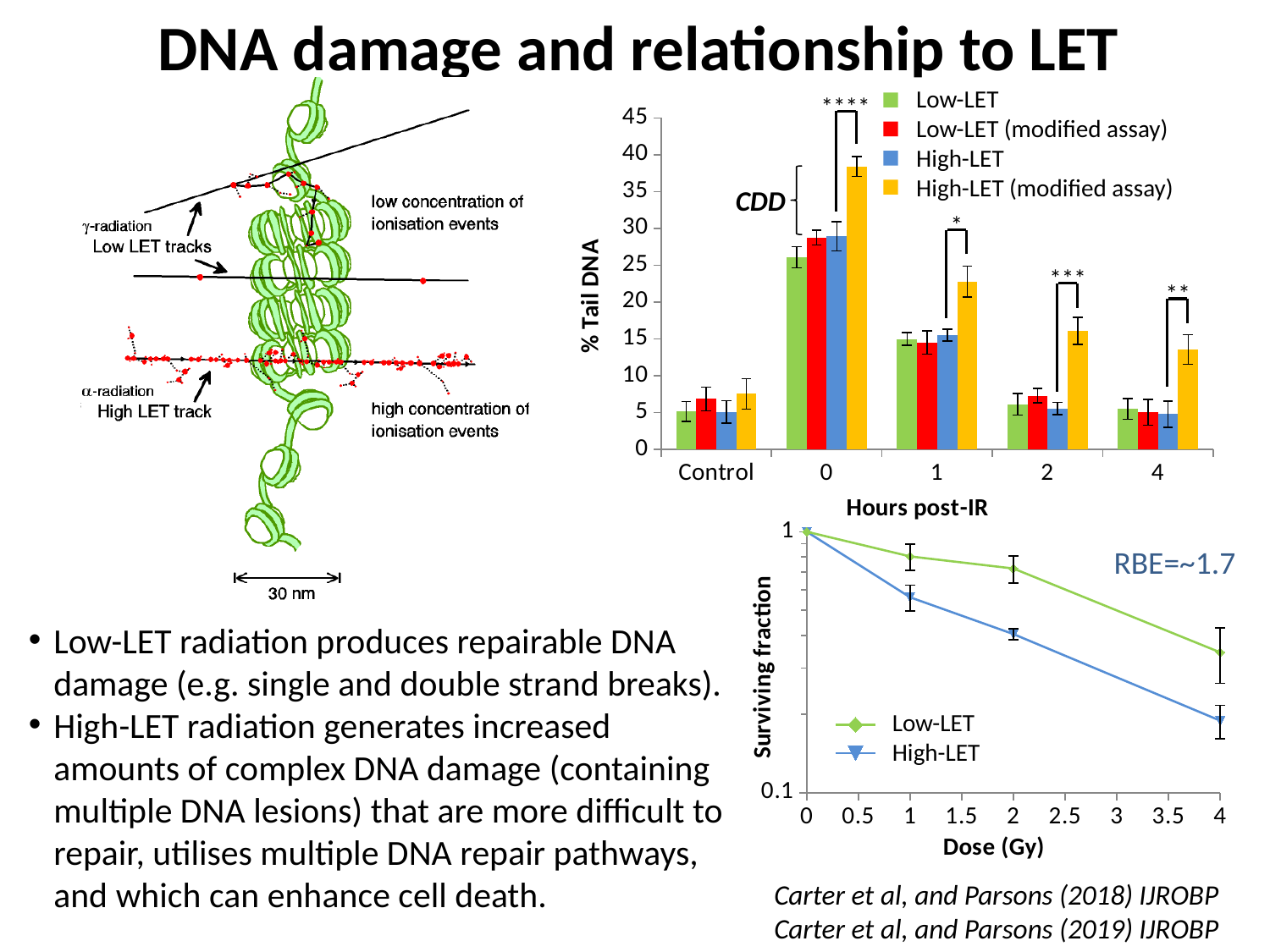
In the '% Tail DNA' bar chart, is the value for High-LET (modified assay) at 1 hour post-IR greater or less than 20? greater In the '% Tail DNA' bar chart, is the value for High-LET (modified assay) at 0 hours post-IR greater or less than 35? greater In the '% Tail DNA' bar chart, is the value for High-LET (modified assay) at 4 hours post-IR greater or less than 15? less What type of chart is the chart titled with the y axis '% Tail DNA'? bar chart In the '% Tail DNA' bar chart, how many categories are shown on the 'Hours post-IR' axis? 5 In the 'Surviving fraction' line chart, which series has the higher value at 4 Gy: Low-LET or High-LET? Low-LET In the '% Tail DNA' bar chart, which series has the highest bar at 0 hours post-IR? High-LET (modified assay) In the 'Surviving fraction' line chart, do the values rise or fall as Dose (Gy) increases? fall In the '% Tail DNA' bar chart, how many series does the legend list? 4 In the '% Tail DNA' bar chart, which is larger at 2 hours post-IR: High-LET or High-LET (modified assay)? High-LET (modified assay) In the '% Tail DNA' bar chart, what is the label of the x axis? Hours post-IR In the 'Surviving fraction' line chart, how many series does the legend list? 2